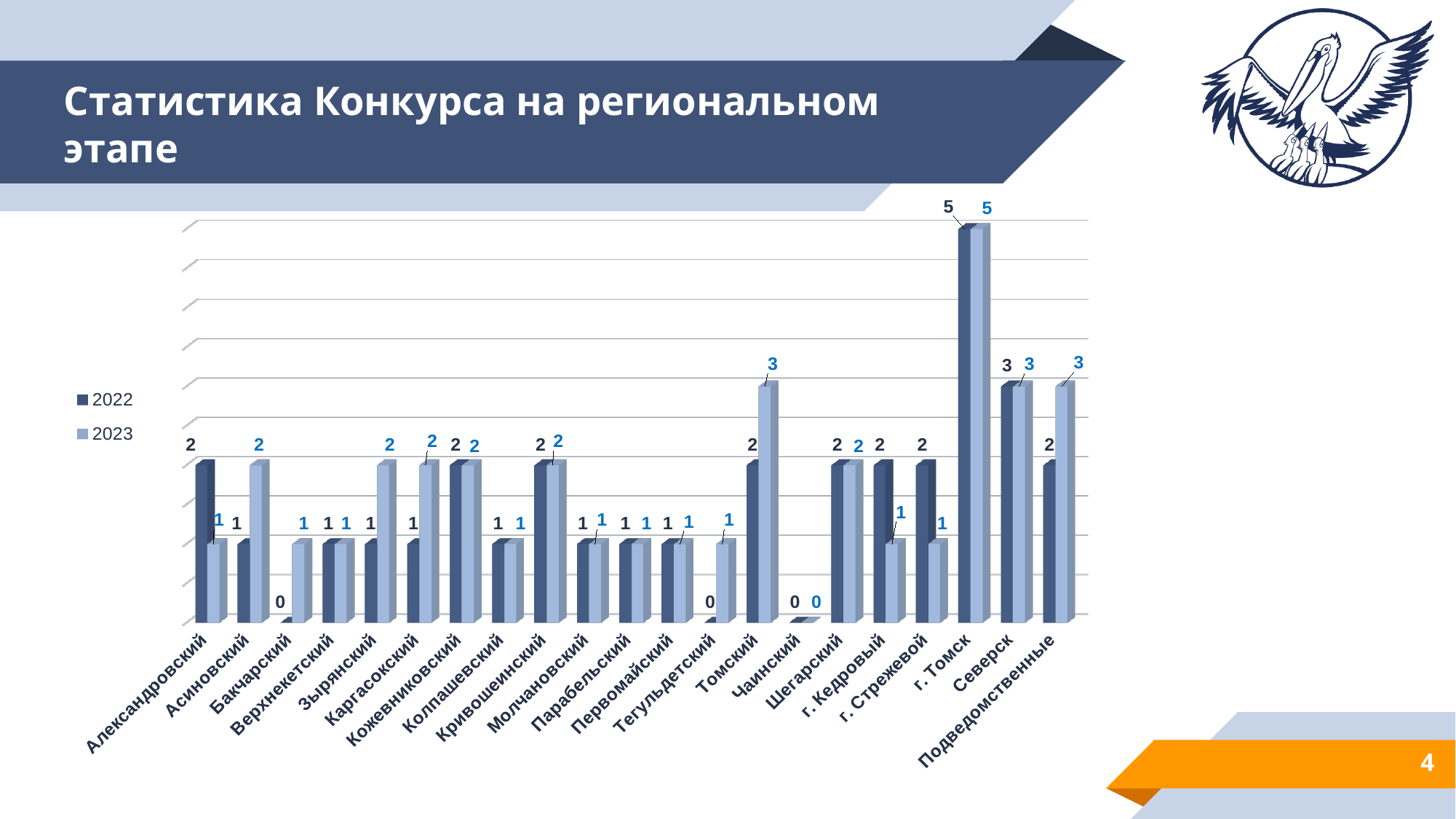
What is the 2022 value for г. Томск? 5 What is the difference between the 2023 and 2022 values for Подведомственные? 1 How many series does the legend list? 2 Which category has a value of 0 in both 2022 and 2023? Чаинский What kind of chart is shown on the slide? Bar chart What are the two series named in the legend? 2022 and 2023 What is the 2022 value for Александровский? 2 What is the 2023 value for Бакчарский? 1 What is the 2023 value for Томский? 3 Which category has the highest 2023 value? г. Томск Which is larger for г. Кедровый: the 2022 value or the 2023 value? 2022 How many categories are shown on the x axis? 21